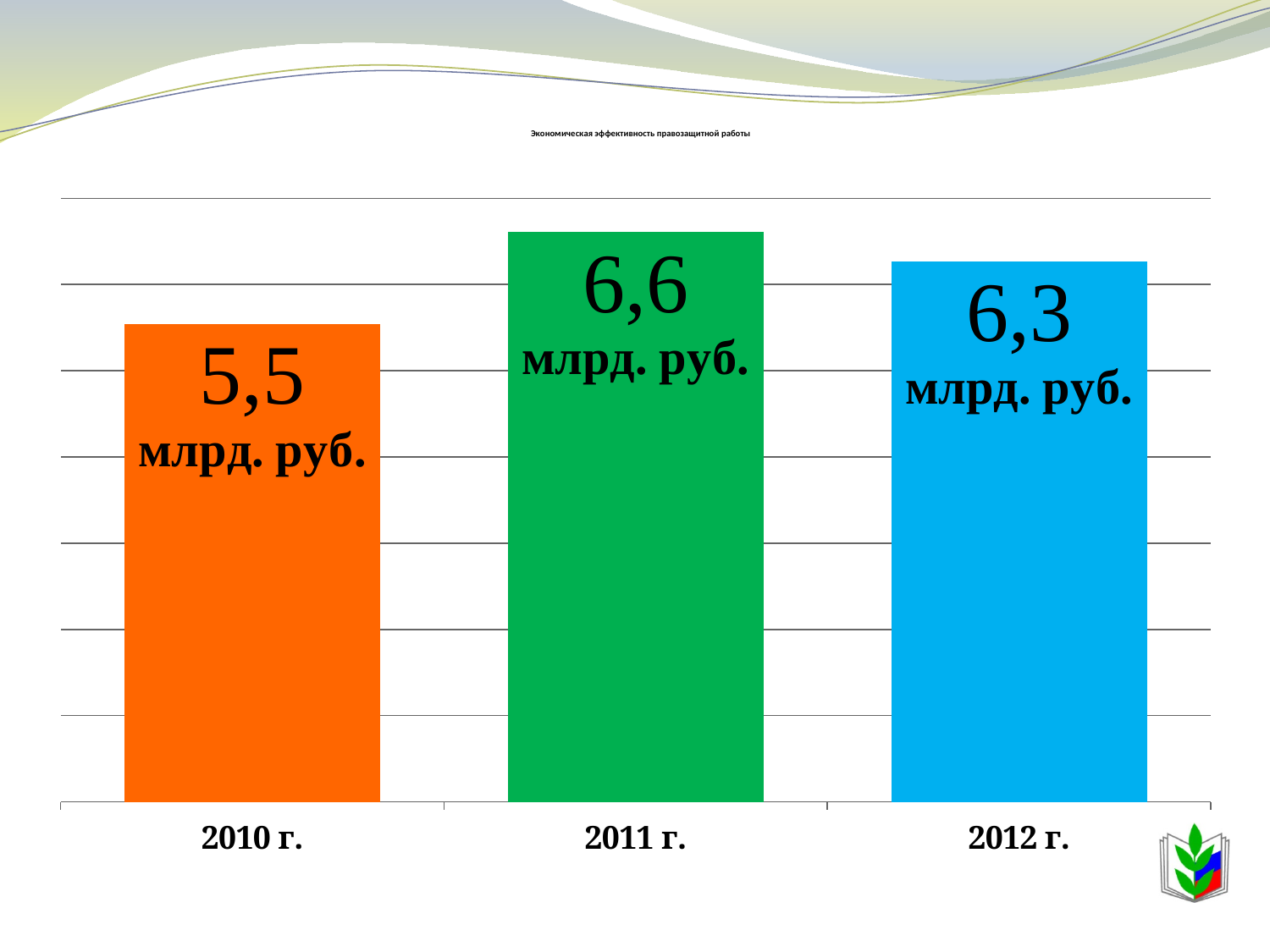
What value is shown for 2012 г.? 6,3 млрд. руб. What kind of chart is shown on the slide? bar chart What value is shown for 2011 г.? 6,6 млрд. руб. Which year has the lowest value? 2010 г. Which is larger, the value for 2012 г. or the value for 2010 г.? 2012 г. Does the value rise or fall from 2011 г. to 2012 г.? fall How many years are shown on the chart? 3 What colour is the bar for 2011 г.? green What is the difference between the values for 2011 г. and 2012 г.? 0,3 млрд. руб. Which year has the highest value? 2011 г. What value is shown for 2010 г.? 5,5 млрд. руб. What is the difference between the values for 2011 г. and 2010 г.? 1,1 млрд. руб.